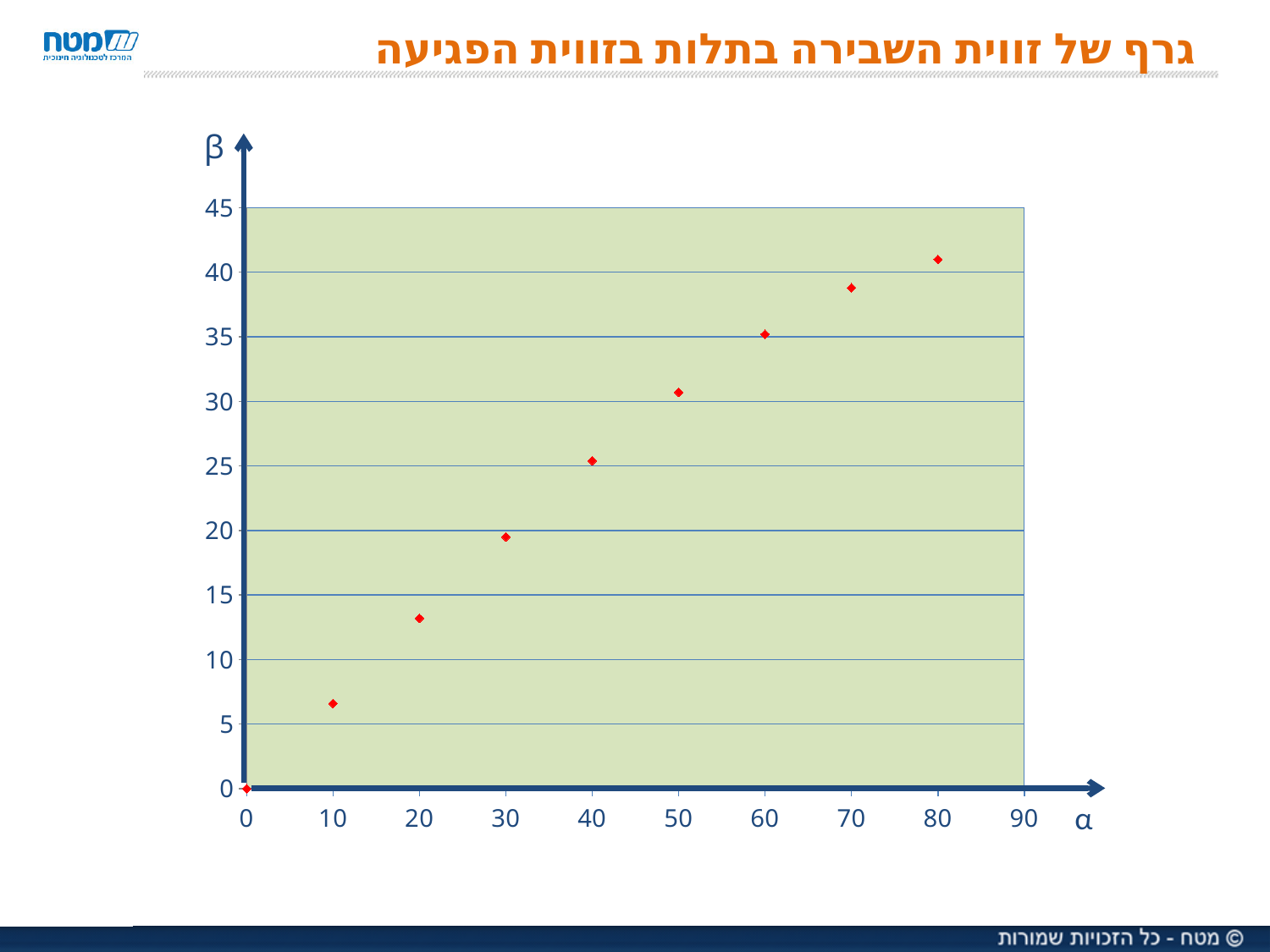
Which has a larger β value: α = 40 or α = 60? α = 60 Is the value of β for α = 80 greater or less than 40? greater How many data points are plotted on the chart? 9 At which α value is β lowest? 0 What kind of chart is shown on the slide? scatter chart Do the β values rise or fall as α increases along the x axis? rise At which α value is β highest? 80 Is the value of β for α = 50 greater or less than 30? greater Is the value of β for α = 70 greater or less than 40? less What label is shown on the vertical axis of the chart? β